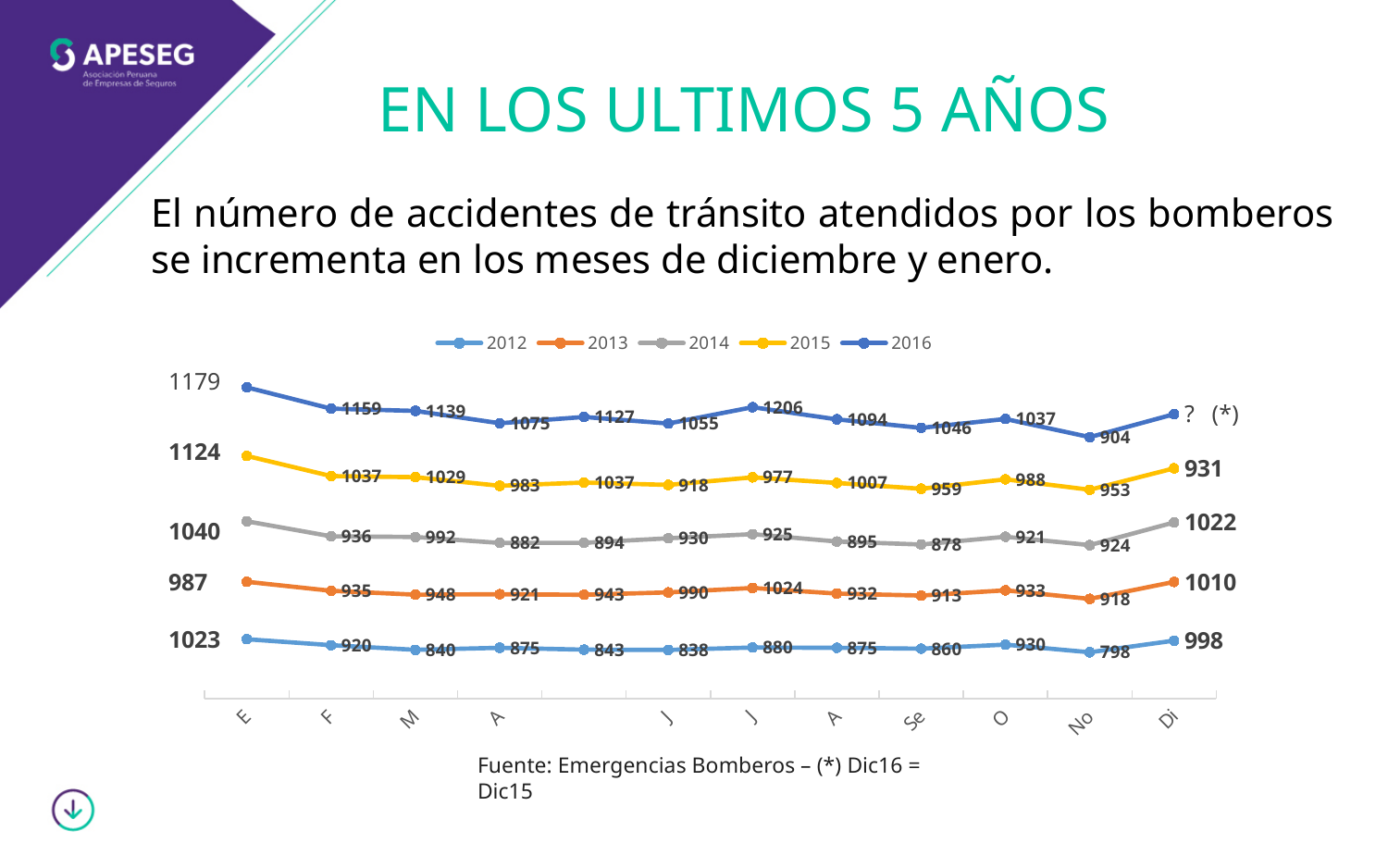
What is the value for the 2014 series at the point labelled 'Di' (December)? 1022 Which years are listed in the chart legend? 2012, 2013, 2014, 2015, 2016 What is the value for the 2015 series at the point labelled 'F' (February)? 1037 What kind of chart is shown on the slide? line chart Which is larger: the 2014 series value at 'Di' (1022) or the 2013 series value at 'Di' (1010)? 2014 (1022) What is the lowest labelled value in the 2012 series? 798 What is the value for the 2012 series at the point labelled 'Di' (December)? 998 How many series does the legend list? 5 According to the source note, what value is used for December 2016, marked with (*)? Dic16 = Dic15 What is the difference between the 2013 series values at 'Di' (1010) and 'No' (918)? 92 What is the highest labelled value in the 2016 series? 1206 What is the value for the 2016 series at the point labelled 'No' (November)? 904